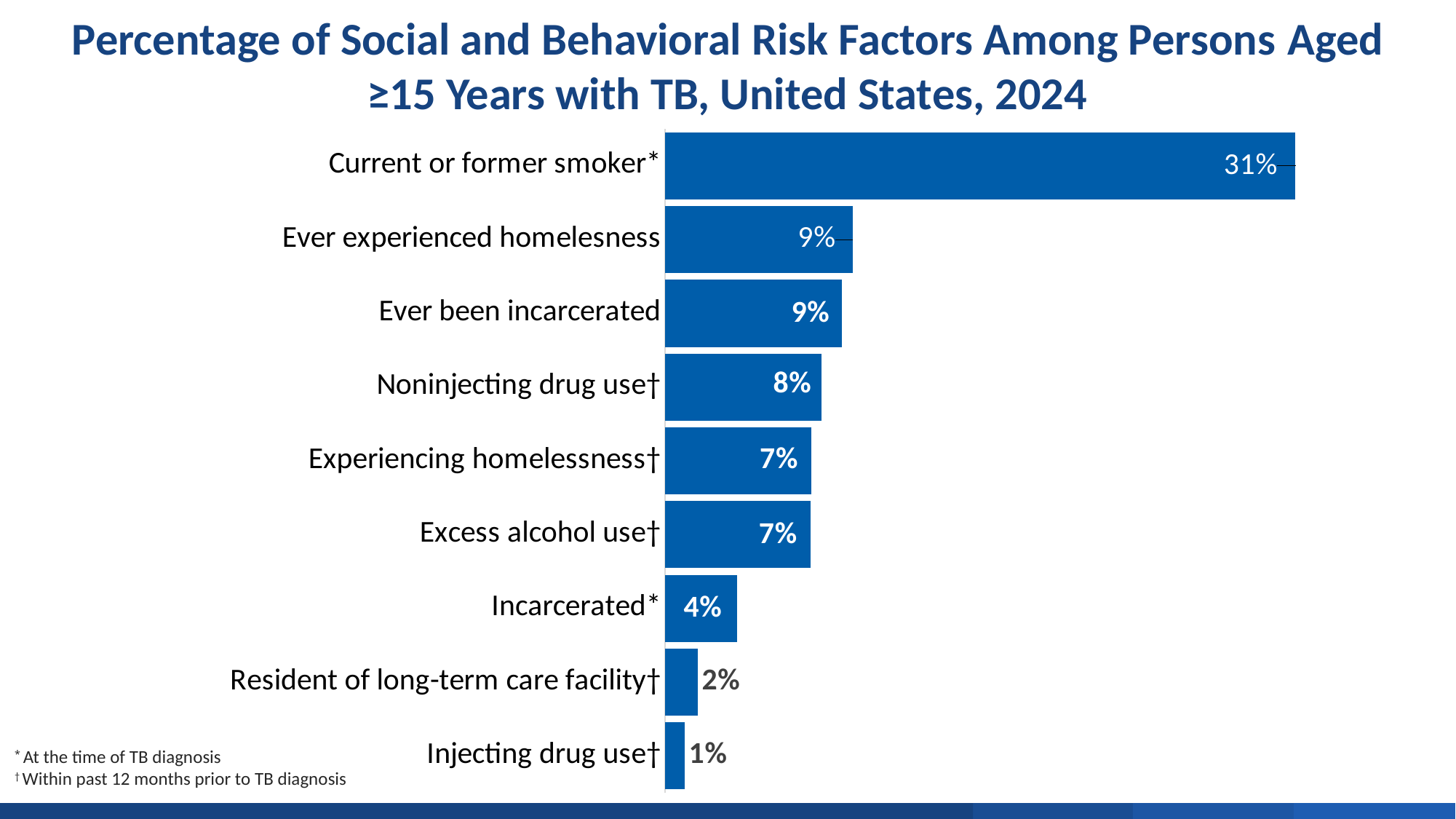
What is the difference between the percentage for Current or former smoker and the percentage for Ever been incarcerated? 22% Which risk factor has the lowest percentage? Injecting drug use What percentage is shown for Excess alcohol use? 7% What percentage is shown for Resident of long-term care facility? 2% According to the footnote, what does the asterisk (*) after a category label indicate? At the time of TB diagnosis What kind of chart is shown on the slide? Bar chart What percentage is shown for Current or former smoker? 31% What is the difference between the percentage for Incarcerated and the percentage for Injecting drug use? 3% How many risk factor categories are shown in the chart? 9 Which risk factor has the highest percentage? Current or former smoker Which is larger, the percentage for Noninjecting drug use or the percentage for Incarcerated? Noninjecting drug use What percentage is shown for Noninjecting drug use? 8%